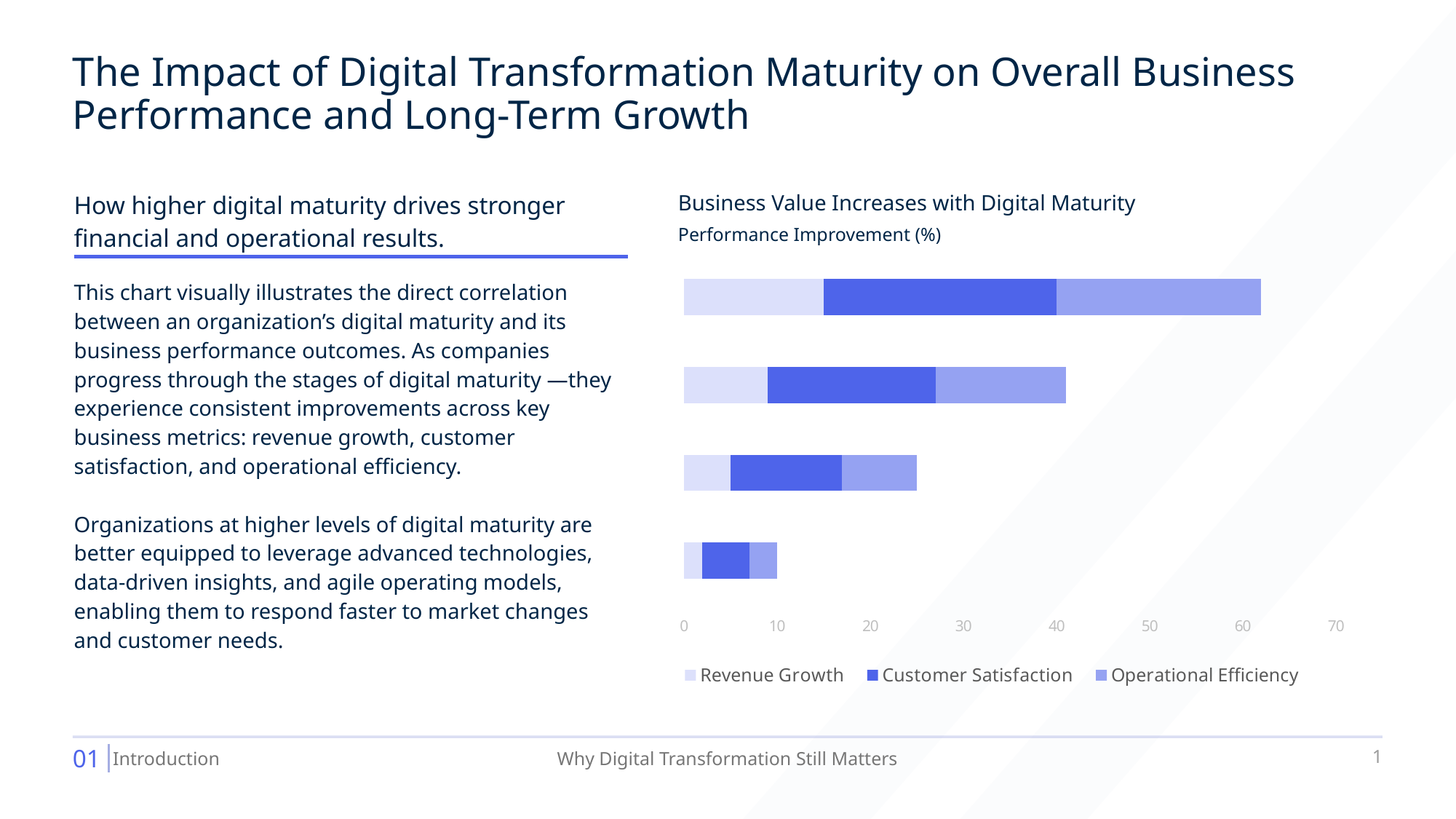
What is the title of the chart? Business Value Increases with Digital Maturity Is the total value of the top bar greater or less than 50? greater How many series does the chart legend list? 3 Which bar has the largest total length? The top bar Is the total value of the bottom bar greater or less than 20? less What are the three series named in the chart legend? Revenue Growth, Customer Satisfaction, Operational Efficiency Is the total value of the second bar from the top greater or less than 30? greater Which bar has the smallest total length? The bottom bar What kind of chart is shown on the slide? Stacked bar chart Which is longer in total, the top bar or the second bar from the top? The top bar How many bars are plotted in the chart? 4